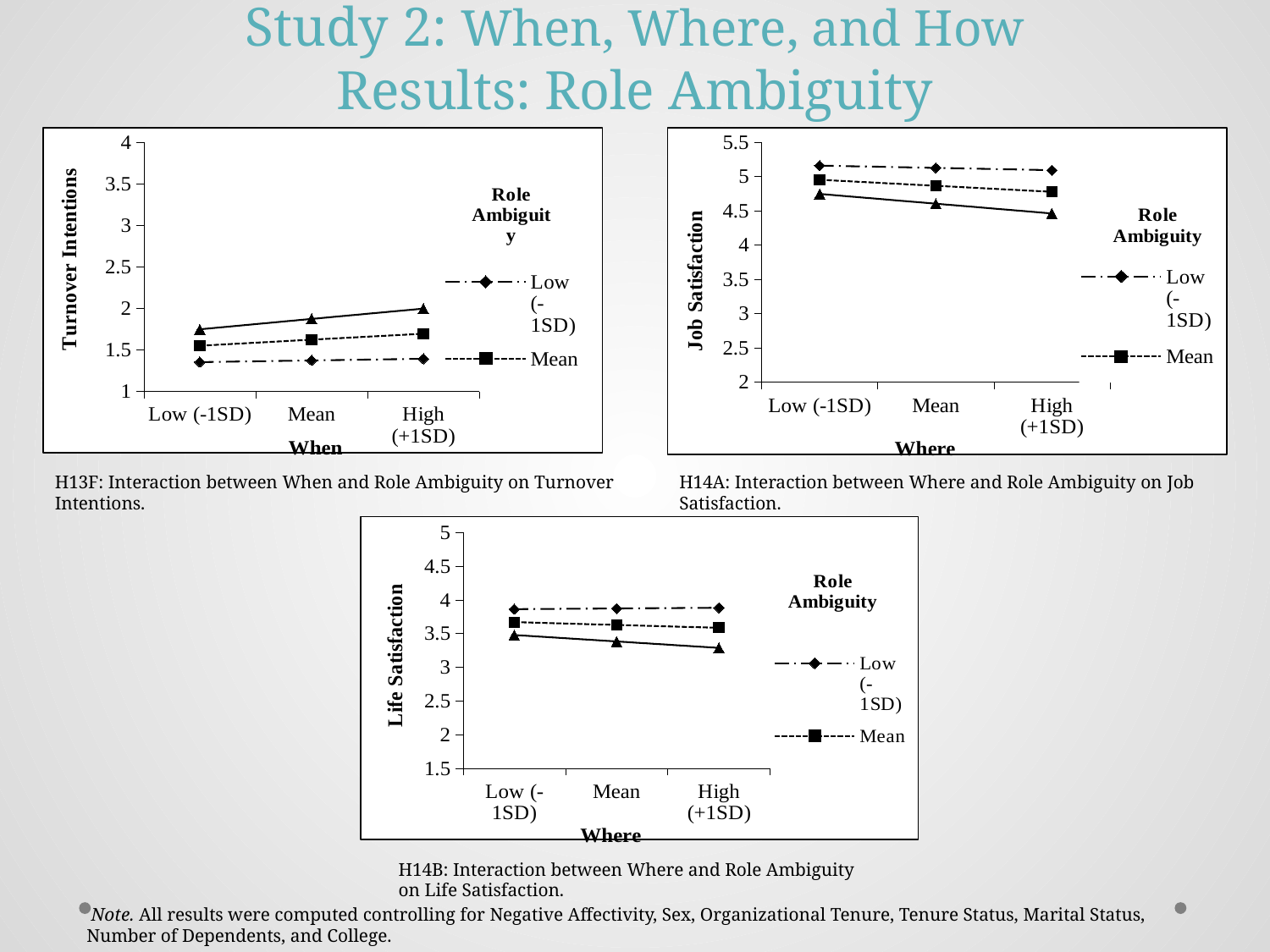
In the 'Turnover Intentions' chart, at High (+1SD), which is larger: the Mean series or the Low (-1SD) series? Mean In the 'Job Satisfaction' chart, does the Mean series rise or fall from Low (-1SD) to High (+1SD)? fall In the 'Turnover Intentions' chart, is the value of the Mean series at High (+1SD) greater or less than 1.5? greater What is the y-axis title of the bottom chart? Life Satisfaction In the 'Life Satisfaction' chart, is the value of the Low (-1SD) series at Mean greater or less than 3.5? greater In the 'Turnover Intentions' chart, is the value of the Low (-1SD) series at High (+1SD) greater or less than 1.5? less How many categories are on the x axis of the 'Job Satisfaction' chart? 3 What kind of chart is the 'Turnover Intentions' chart on the left? line chart In the 'Turnover Intentions' chart, does the Mean series rise or fall from Low (-1SD) to High (+1SD)? rise What is the x-axis title of the 'Turnover Intentions' chart? When